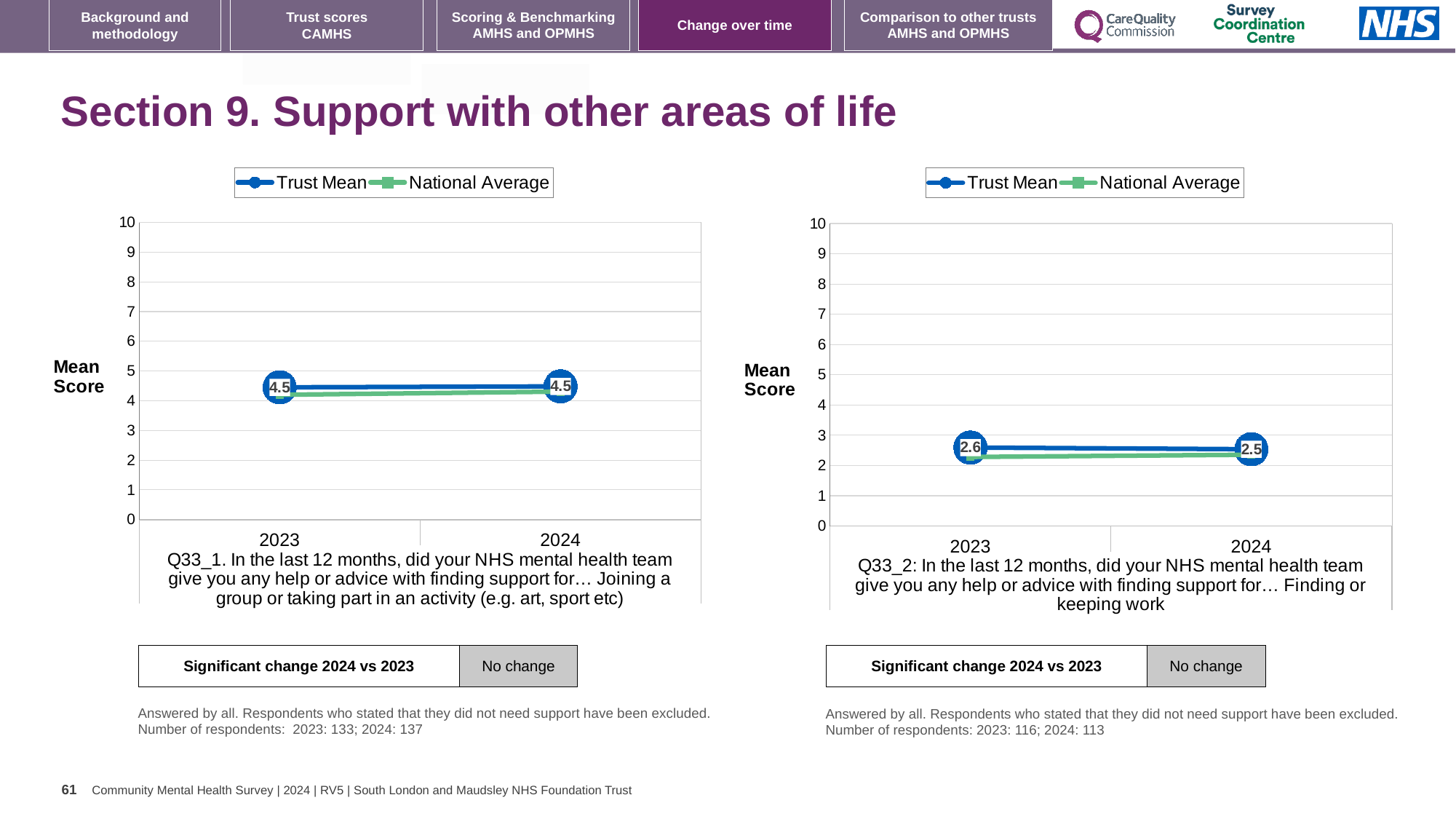
On the left chart (Q33_1), what is the Trust Mean for 2024? 4.5 What type of chart is the left chart (Q33_1)? Line chart On the right chart (Q33_2), what is the difference between the Trust Mean for 2023 and 2024? 0.1 On the right chart (Q33_2), does the Trust Mean rise or fall from 2023 to 2024? Fall On the right chart (Q33_2), what is the Trust Mean for 2023? 2.6 On the left chart (Q33_1), is the National Average for 2023 greater or less than 5? less On the right chart (Q33_2), is the National Average for 2024 greater or less than 3? less On the left chart (Q33_1), what is the Trust Mean for 2023? 4.5 On the right chart (Q33_2), which year has the higher Trust Mean, 2023 or 2024? 2023 How many years are shown on the x axis of the left chart (Q33_1)? 2 How many series does the legend of the right chart (Q33_2) list? 2 On the right chart (Q33_2), what is the Trust Mean for 2024? 2.5